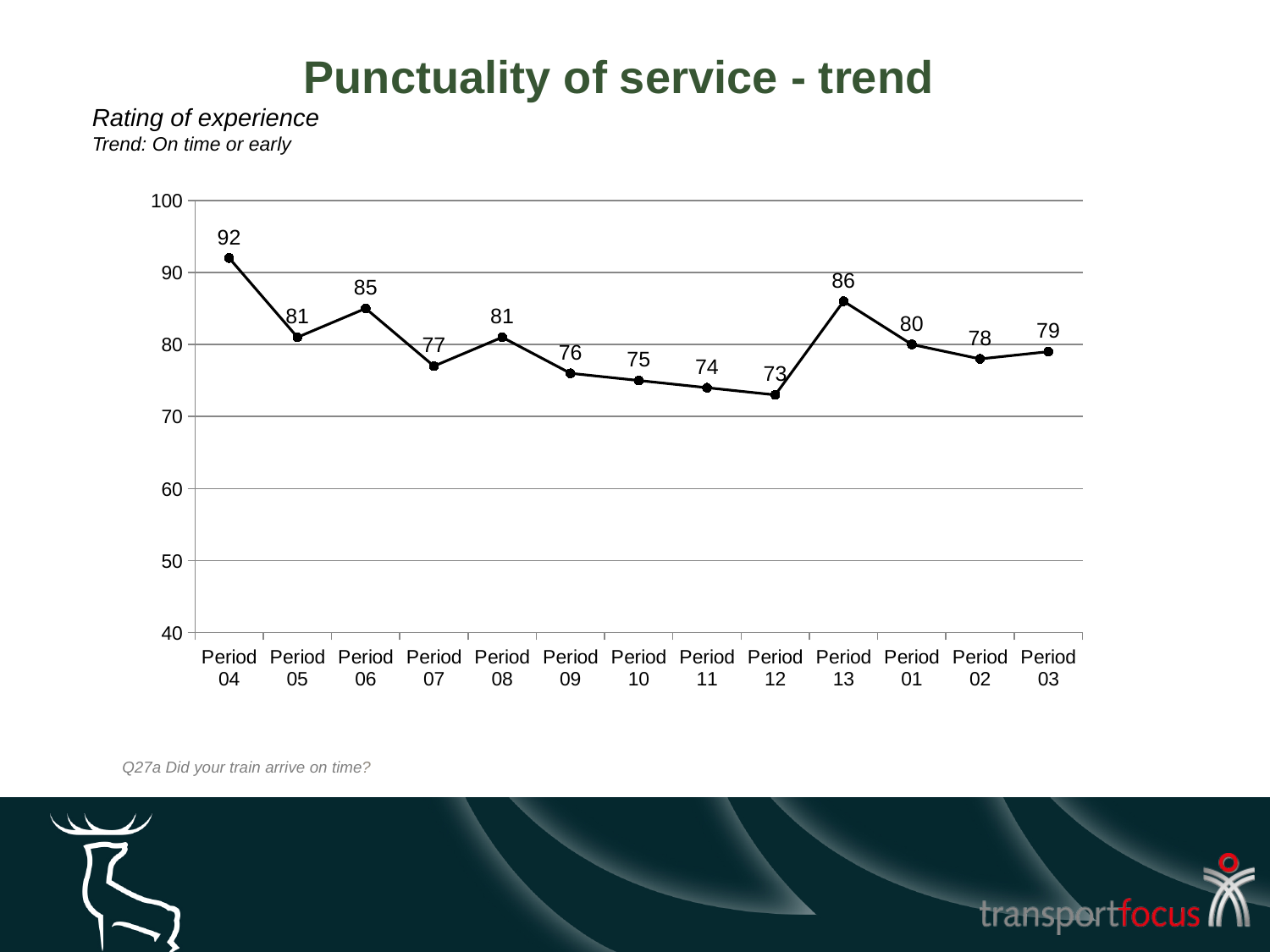
What is the value for Period 12? 73 Which period has the highest value? Period 04 What is the difference between the values for Period 04 and Period 12? 19 What is the value for Period 13? 86 Which period has the lowest value? Period 12 How many periods are plotted on the chart? 13 What is the value for Period 04? 92 What kind of chart is shown on the slide? Line chart Do the values rise or fall from Period 08 to Period 12? Fall Which is larger, the value for Period 06 or the value for Period 08? Period 06 What is the value for Period 03? 79 What is the difference between the values for Period 13 and Period 01? 6